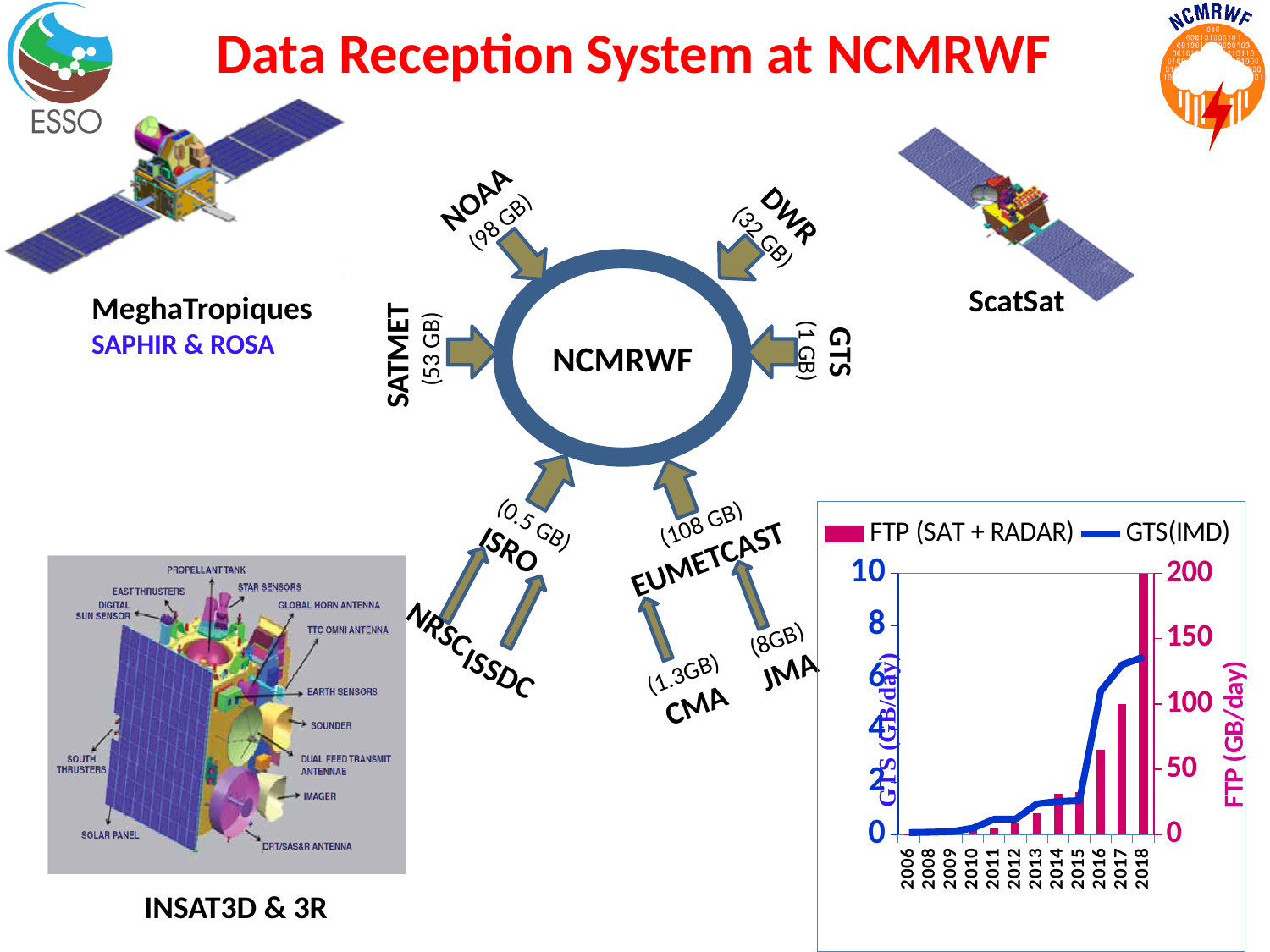
In the bottom-right chart, does the GTS(IMD) line rise or fall from 2006 to 2018? rise In the bottom-right chart, which year has the highest FTP (SAT + RADAR) bar? 2018 In the bottom-right chart, is the GTS(IMD) value for 2014 greater or less than 2? less How many years are shown on the x axis of the bottom-right chart? 12 In the bottom-right chart, is the GTS(IMD) value for 2018 greater or less than 4? greater In the bottom-right chart, which year has the larger FTP (SAT + RADAR) bar, 2016 or 2017? 2017 What is the label of the right-hand vertical axis of the bottom-right chart? FTP (GB/day) How many series does the legend of the bottom-right chart list? 2 In the bottom-right chart, is the FTP (SAT + RADAR) value for 2016 greater or less than 100? less What kind of chart is shown in the bottom-right of the slide? bar and line chart What are the two legend entries of the bottom-right chart? FTP (SAT + RADAR) and GTS(IMD)